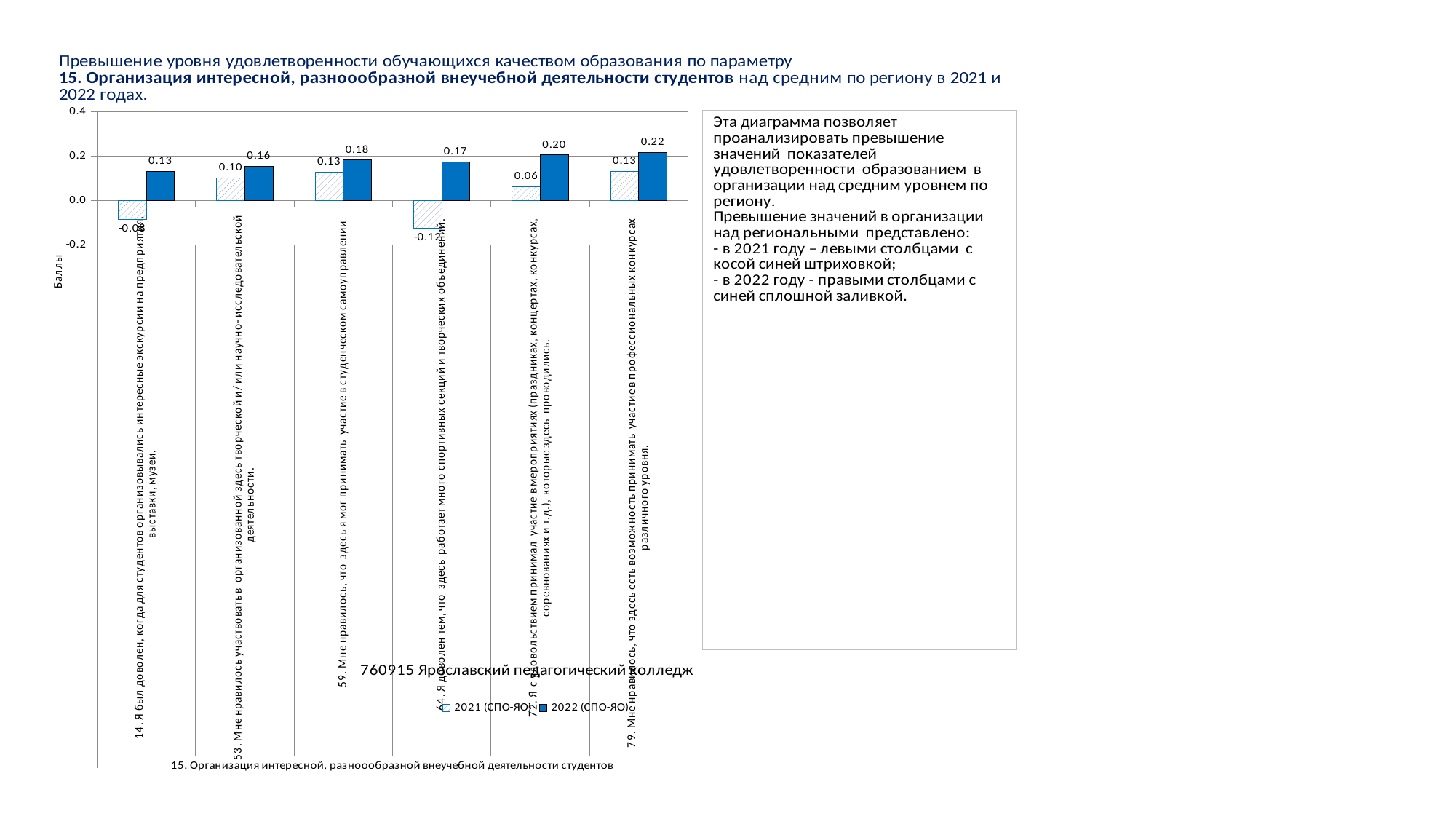
Какое значение показано для 2021 (СПО-ЯО) по утверждению 72 «Я с удовольствием принимал участие в мероприятиях (праздниках, концертах, соревнованиях и т.д.)»? 0.06 Какого типа эта диаграмма? Столбчатая (bar chart) Какое значение больше: 2022 (СПО-ЯО) по утверждению 53 или 2022 (СПО-ЯО) по утверждению 59? 2022 (СПО-ЯО) по утверждению 59 Сколько рядов данных указано в легенде диаграммы? 2 На сколько значение 2022 (СПО-ЯО) по утверждению 72 больше значения 2021 (СПО-ЯО) по тому же утверждению? 0.14 По какому утверждению значение 2021 (СПО-ЯО) самое низкое? 64. Я доволен тем, что здесь работает много спортивных секций и творческих объединений. Какое значение показано для 2021 (СПО-ЯО) по утверждению 64 «Я доволен тем, что здесь работает много спортивных секций и творческих объединений»? -0.12 По какому утверждению значение 2022 (СПО-ЯО) самое высокое? 79. Мне нравилось, что здесь есть возможность принимать участие в профессиональных конкурсах различного уровня. Как называется вертикальная ось диаграммы? Баллы Сколько утверждений (категорий) показано на диаграмме? 6 Какое значение показано для 2022 (СПО-ЯО) по утверждению 79 «Мне нравилось, что здесь есть возможность принимать участие в профессиональных конкурсах различного уровня»? 0.22 Значение 2021 (СПО-ЯО) по утверждению 14 больше или меньше 0.0? меньше